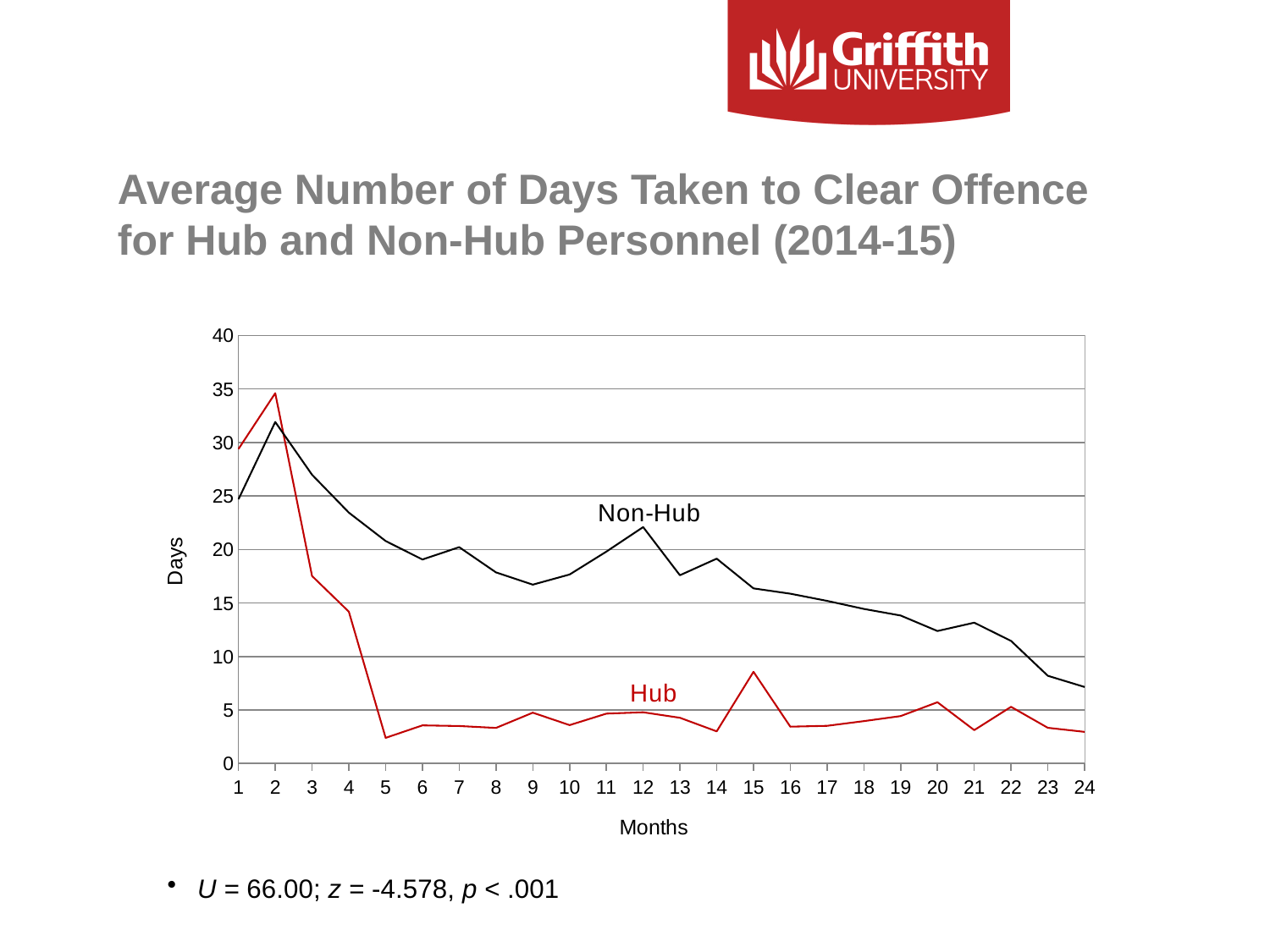
What kind of chart is shown on the slide? line chart In which month does the Hub series reach its highest value? 2 How many data series are plotted on the chart? 2 Does the Non-Hub series generally rise or fall from month 2 to month 24? fall At month 12, which series has the larger value, Hub or Non-Hub? Non-Hub Is the Non-Hub value at month 1 greater or less than 20? greater What is the title of the y axis? Days Is the Hub value at month 2 greater or less than 30? greater In which month does the Non-Hub series reach its highest value? 2 How many months are plotted along the x axis? 24 Is the Non-Hub value at month 24 greater or less than 10? less